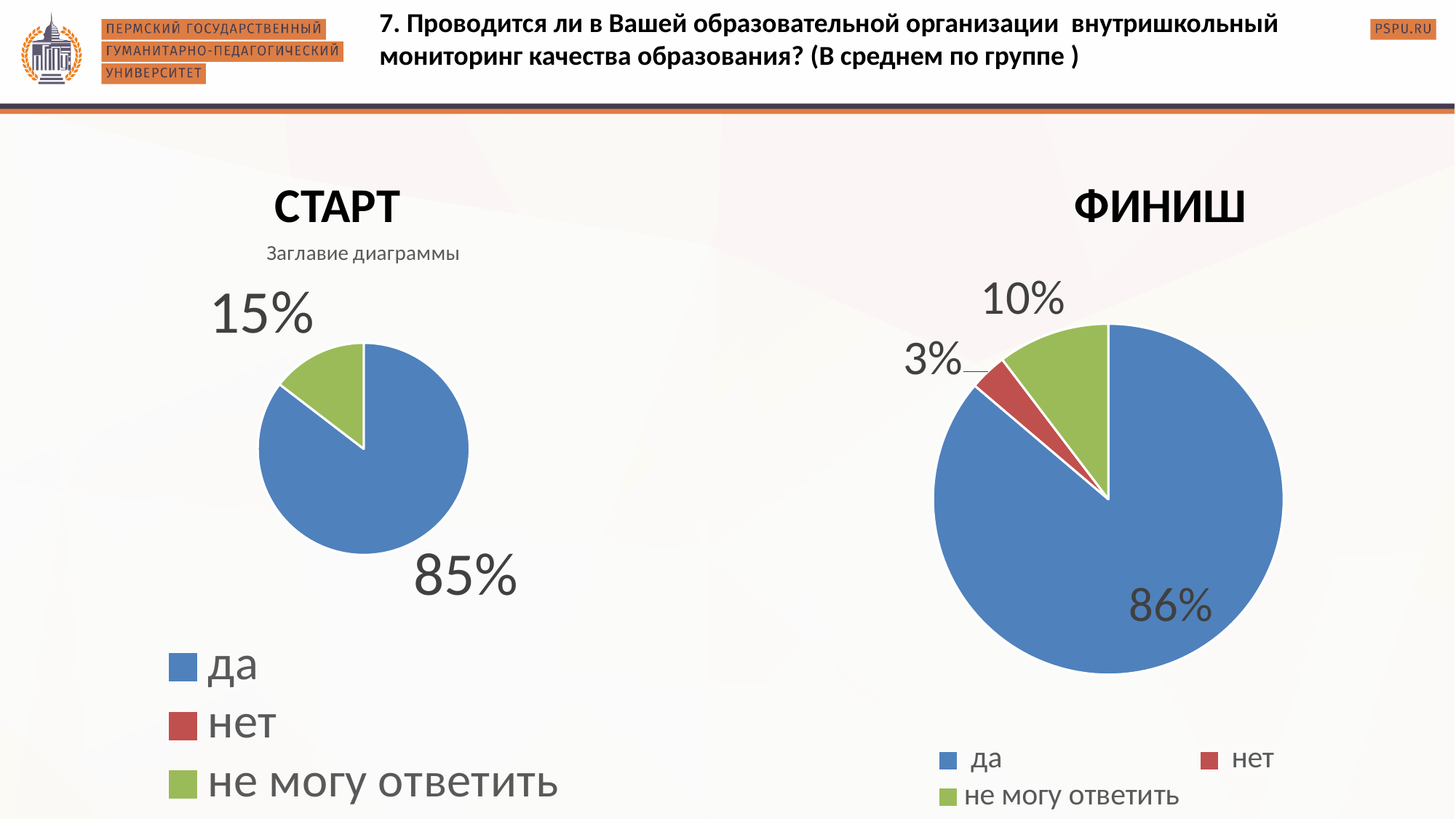
How many entries does the legend of the ФИНИШ chart list? 3 In the ФИНИШ pie chart, what share is labelled for "да"? 86% In the ФИНИШ pie chart, which category has the smallest slice? нет Which is larger: the share for "да" in the СТАРТ chart or the share for "да" in the ФИНИШ chart? ФИНИШ (86%) In the СТАРТ pie chart, what share is labelled for "не могу ответить"? 15% In the СТАРТ pie chart, what colour is the slice for "не могу ответить"? Green What type of chart is used for the СТАРТ data? Pie chart In the ФИНИШ pie chart, which category has the largest slice? да In the ФИНИШ pie chart, what share is labelled for "нет"? 3% In the ФИНИШ pie chart, what share is labelled for "не могу ответить"? 10% In the СТАРТ pie chart, what share is labelled for "да"? 85% In the ФИНИШ pie chart, what is the difference between the shares for "да" and "не могу ответить"? 76%